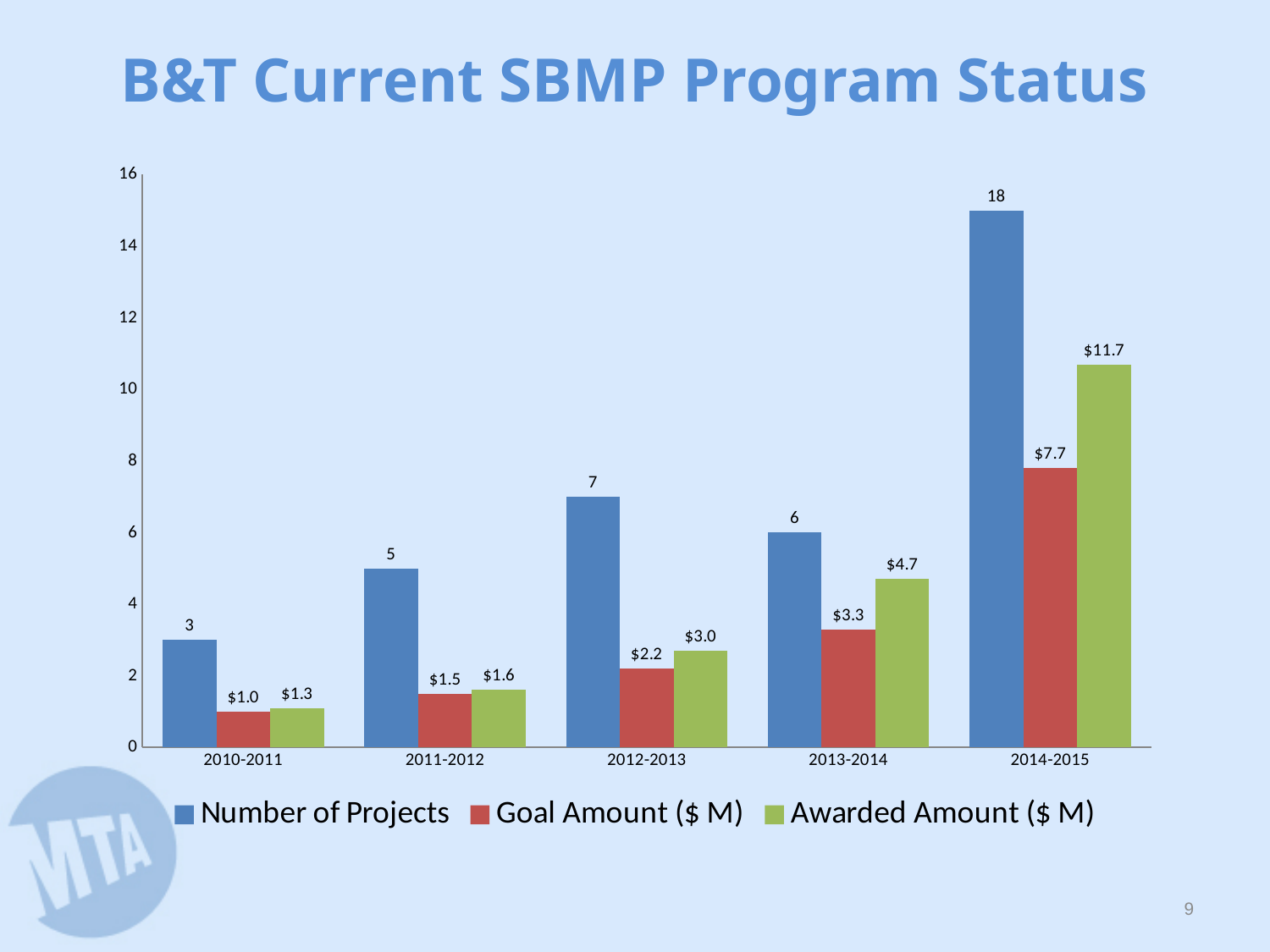
Does the Awarded Amount ($ M) rise or fall from 2010-2011 to 2014-2015? rise How many year categories are shown on the x axis? 5 Which is larger for 2012-2013, the Goal Amount or the Awarded Amount? Awarded Amount Which year has the lowest Number of Projects? 2010-2011 What is the Awarded Amount ($ M) for 2014-2015? $11.7 How many series does the legend list? 3 Which year has the highest Goal Amount ($ M)? 2014-2015 What is the Goal Amount ($ M) for 2012-2013? $2.2 What is the Awarded Amount ($ M) for 2013-2014? $4.7 What type of chart is shown on the slide? bar chart What is the Number of Projects for 2011-2012? 5 What is the difference between the Awarded Amount and the Goal Amount for 2014-2015? $4.0